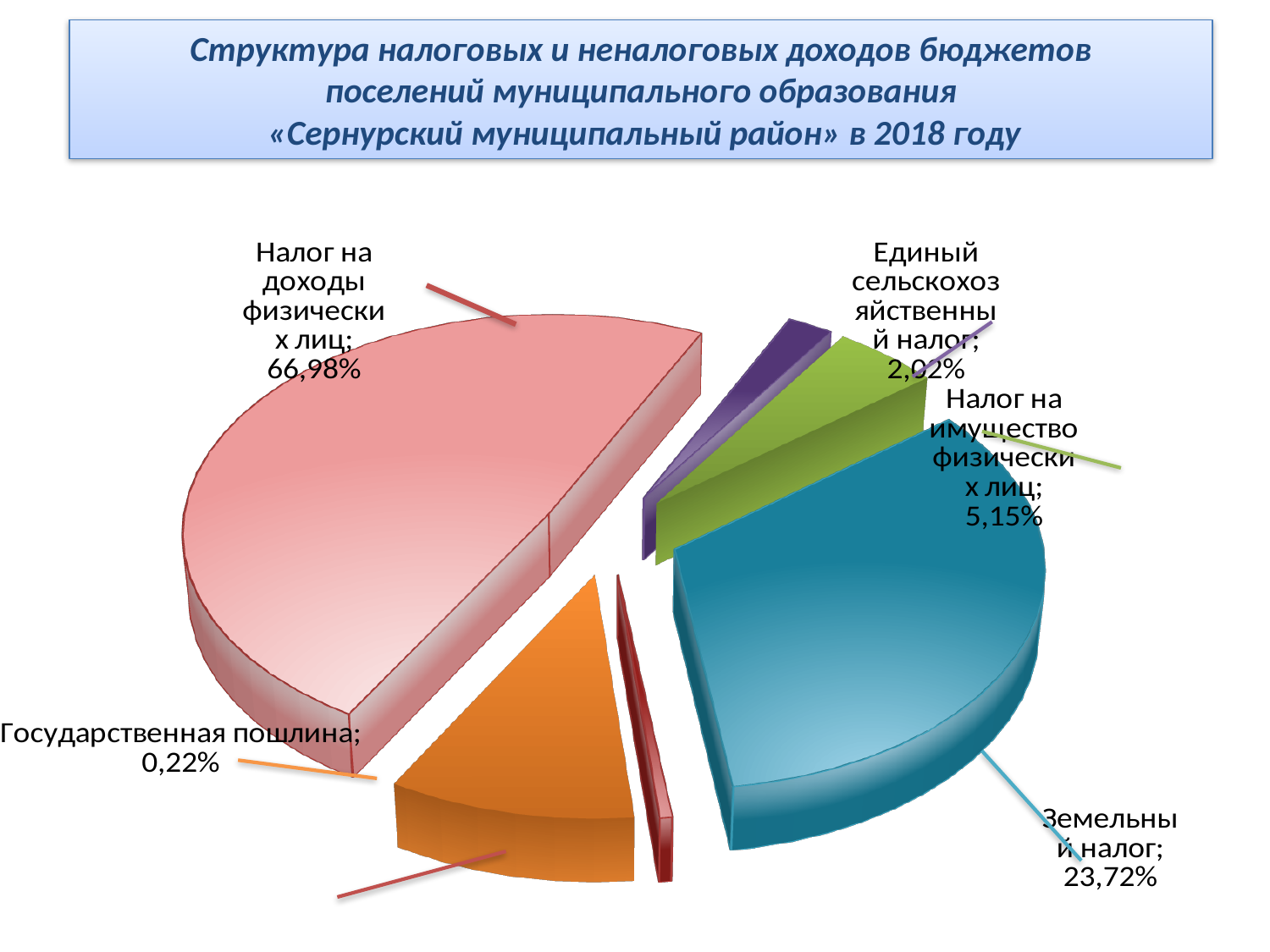
Which year does the chart title refer to? 2018 Which is larger: Земельный налог or Налог на имущество физических лиц? Земельный налог What colour is the slice for Земельный налог? Blue What share does Земельный налог have in the pie chart? 23,72% Which is larger: Налог на имущество физических лиц or Государственная пошлина? Налог на имущество физических лиц By how many percentage points does Земельный налог exceed Налог на имущество физических лиц? 18,57 What type of chart is shown on the slide? Pie chart Which category has the largest share of the pie? Налог на доходы физических лиц What share does Налог на доходы физических лиц have in the pie chart? 66,98% By how many percentage points does Налог на доходы физических лиц exceed Земельный налог? 43,26 What share does Государственная пошлина have in the pie chart? 0,22% What share does Налог на имущество физических лиц have in the pie chart? 5,15%